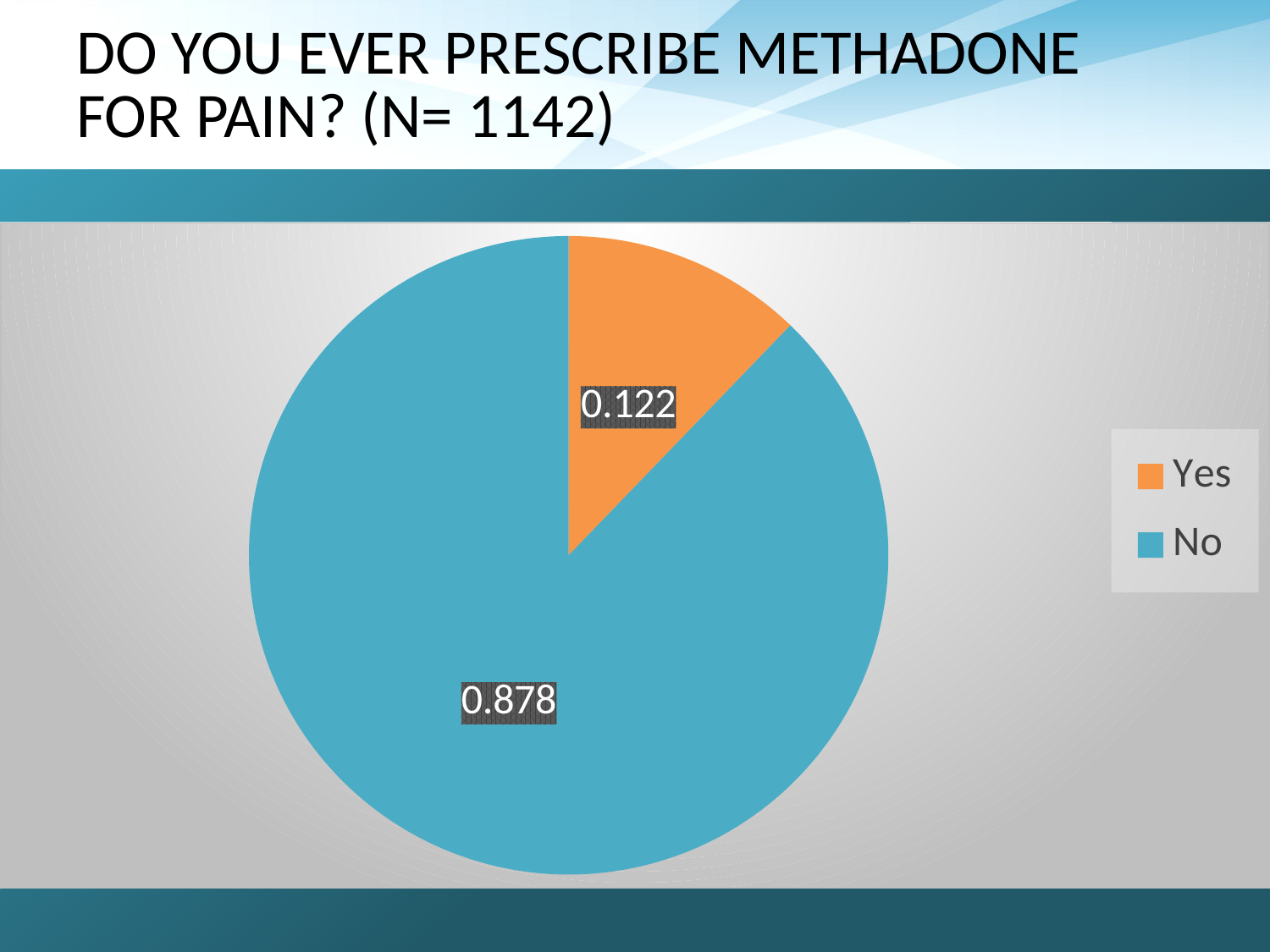
How many entries does the legend list? 2 What colour is the Yes slice? orange How many categories does the pie chart show? 2 What sample size (N) is given in the slide title? 1142 Which is larger, the Yes slice or the No slice? No What is the value shown for the No slice? 0.878 What kind of chart is shown on the slide? pie chart Which category has the largest slice of the pie? No What is the value shown for the Yes slice? 0.122 What is the difference between the No value and the Yes value? 0.756 Which category has the smallest slice of the pie? Yes